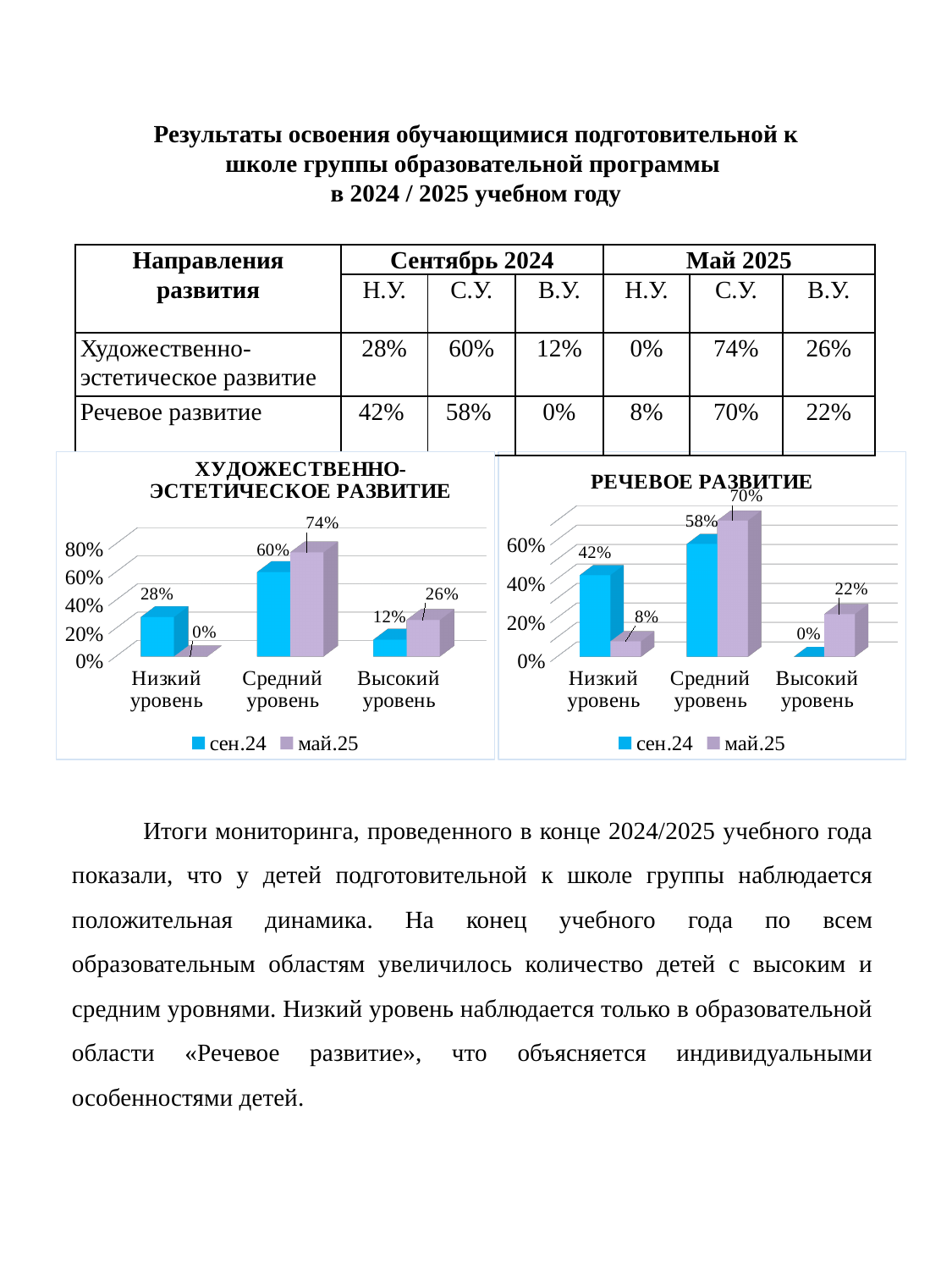
In the chart titled «ХУДОЖЕСТВЕННО-ЭСТЕТИЧЕСКОЕ РАЗВИТИЕ», what is the value for «Средний уровень» in the май.25 series? 74% In the chart titled «РЕЧЕВОЕ РАЗВИТИЕ», what is the difference between the май.25 and сен.24 values for «Средний уровень»? 12% In the chart titled «ХУДОЖЕСТВЕННО-ЭСТЕТИЧЕСКОЕ РАЗВИТИЕ», which colour represents the май.25 series? Purple How many level categories are shown on the x axis of the chart titled «РЕЧЕВОЕ РАЗВИТИЕ»? 3 What type of chart is the chart titled «РЕЧЕВОЕ РАЗВИТИЕ»? Bar chart In the chart titled «РЕЧЕВОЕ РАЗВИТИЕ», what is the value for «Высокий уровень» in the май.25 series? 22% In the chart titled «РЕЧЕВОЕ РАЗВИТИЕ», is the сен.24 value for «Низкий уровень» greater or less than 40%? greater In the chart titled «РЕЧЕВОЕ РАЗВИТИЕ», which level has the highest value in the сен.24 series? Средний уровень In the chart titled «ХУДОЖЕСТВЕННО-ЭСТЕТИЧЕСКОЕ РАЗВИТИЕ», which is larger for «Высокий уровень»: the сен.24 value or the май.25 value? май.25 In the chart titled «ХУДОЖЕСТВЕННО-ЭСТЕТИЧЕСКОЕ РАЗВИТИЕ», what is the value for «Низкий уровень» in the сен.24 series? 28% How many series does the legend of the chart titled «ХУДОЖЕСТВЕННО-ЭСТЕТИЧЕСКОЕ РАЗВИТИЕ» list? 2 In the chart titled «ХУДОЖЕСТВЕННО-ЭСТЕТИЧЕСКОЕ РАЗВИТИЕ», which level has the lowest value in the май.25 series? Низкий уровень